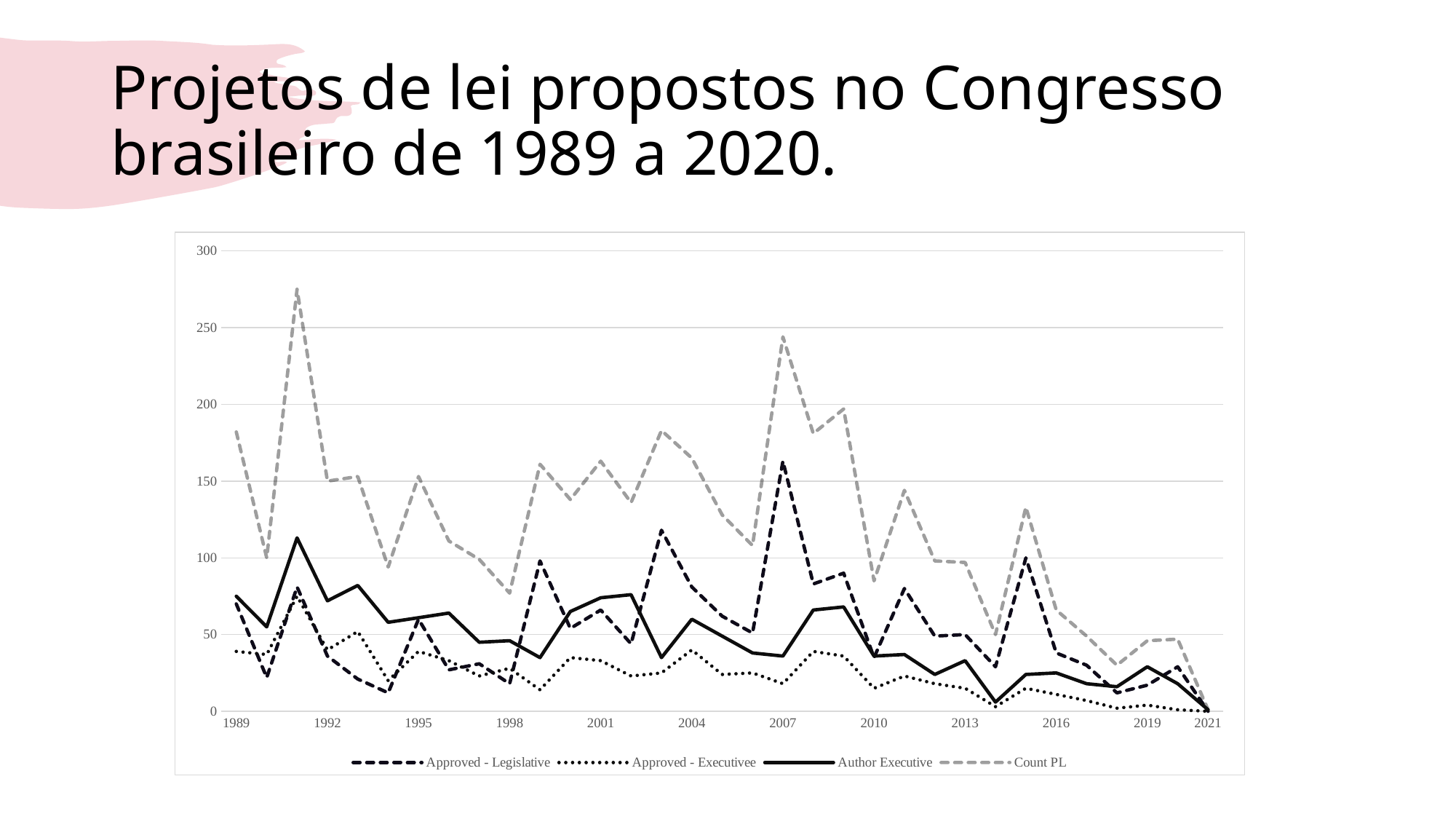
In which year does the Count PL series reach its highest value? 1991 Is the value of Author Executive in 1991 greater or less than 100? greater Which series has the highest values across the chart? Count PL What are the four series listed in the chart legend? Approved - Legislative, Approved - Executivee, Author Executive, Count PL Is the value of Count PL in 1991 greater or less than 250? greater In 2007, which is larger: Approved - Legislative or Author Executive? Approved - Legislative How many series does the chart legend list? 4 Is the value of Count PL in 2007 greater or less than 200? greater Which series is drawn as a solid black line? Author Executive Does the Count PL series rise or fall from 2015 to 2021? Fall What kind of chart is shown on the slide? Line chart